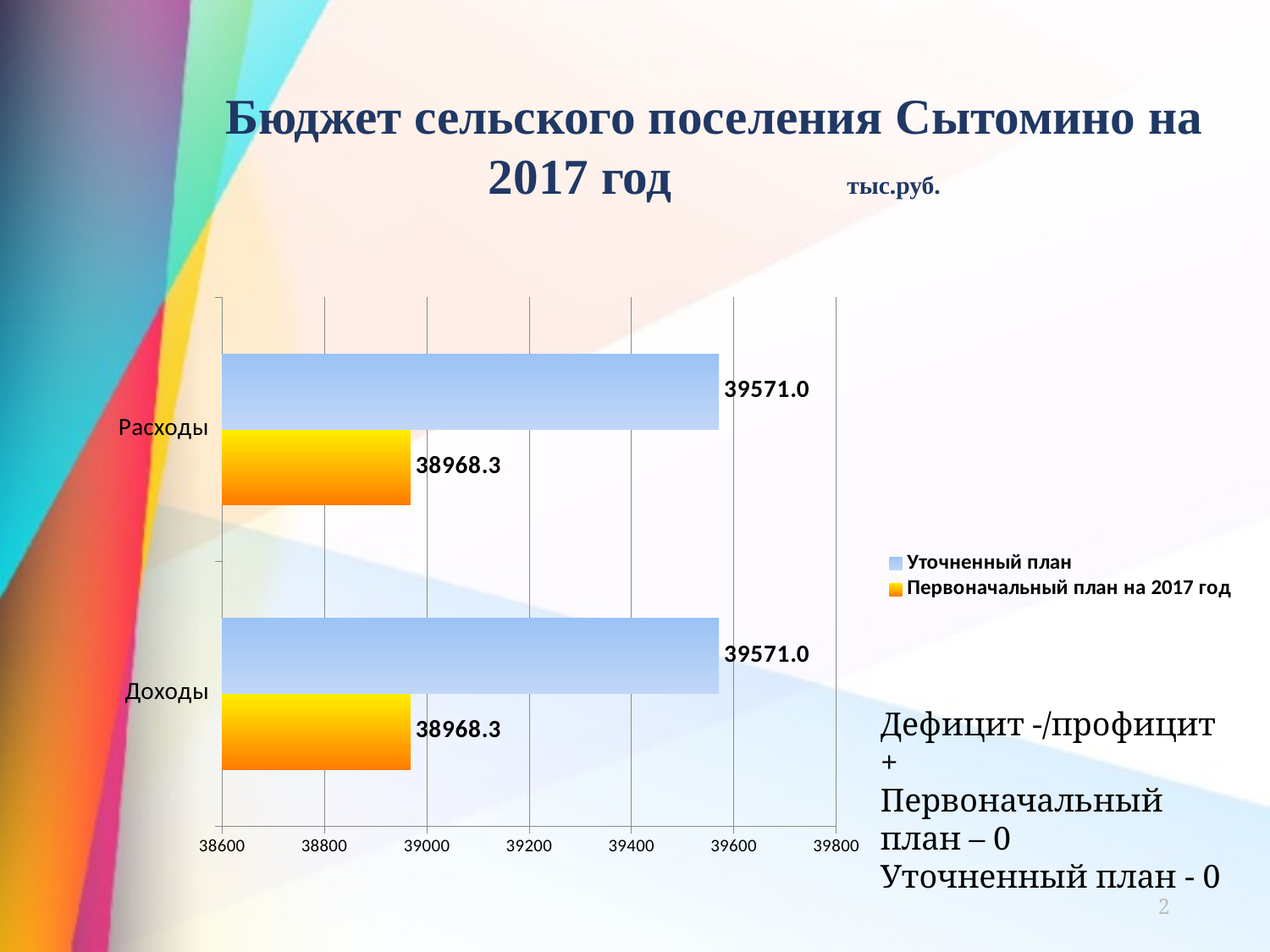
What unit is indicated next to the chart title? тыс.руб. Is the value of Первоначальный план на 2017 год for Доходы greater or less than 39000? less Which series is shown in orange in the legend? Первоначальный план на 2017 год What is the value of Уточненный план for Расходы? 39571.0 How many series does the legend list? 2 What is the value of Первоначальный план на 2017 год for Расходы? 38968.3 What is the value of Первоначальный план на 2017 год for Доходы? 38968.3 Which is larger for Доходы: Уточненный план or Первоначальный план на 2017 год? Уточненный план What kind of chart is shown on the slide? bar chart How many categories are shown on the chart? 2 What is the value of Уточненный план for Доходы? 39571.0 What is the difference between Уточненный план and Первоначальный план на 2017 год for Расходы? 602.7